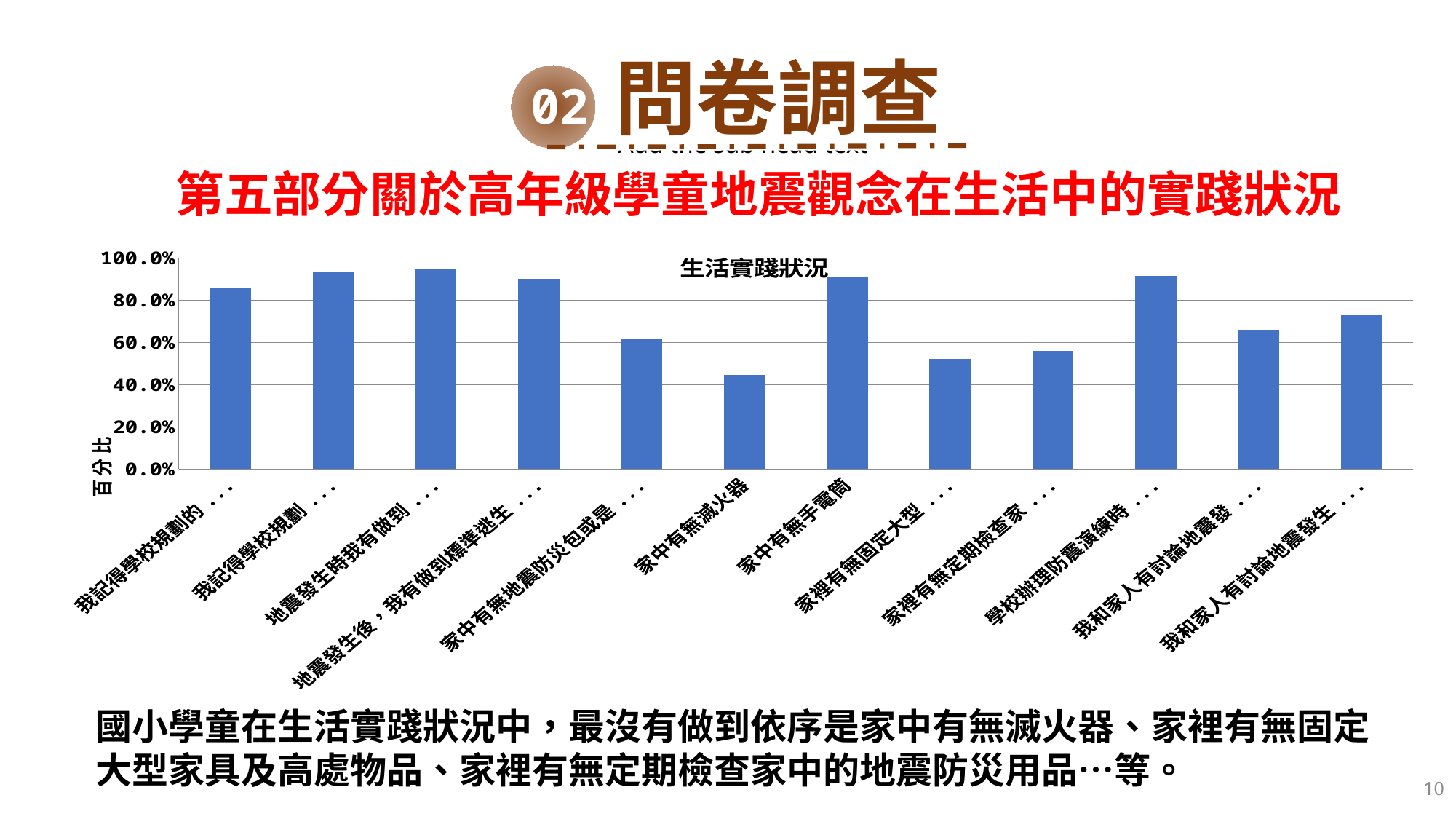
Is the value for the category starting with 學校辦理防震演練時 greater or less than 80.0%? greater Which category has the lowest value in the chart? 家中有無滅火器 What kind of chart is shown on the slide? bar chart What is the title of the chart? 生活實踐狀況 Is the value for the category starting with 家裡有無固定大型 greater or less than 60.0%? less Is the value for the category starting with 我和家人有討論地震發生 greater or less than 80.0%? less What is the label of the vertical axis? 百分比 How many bars (categories) does the chart show? 12 Which is larger, the value for 家中有無手電筒 or the value for 家中有無滅火器? 家中有無手電筒